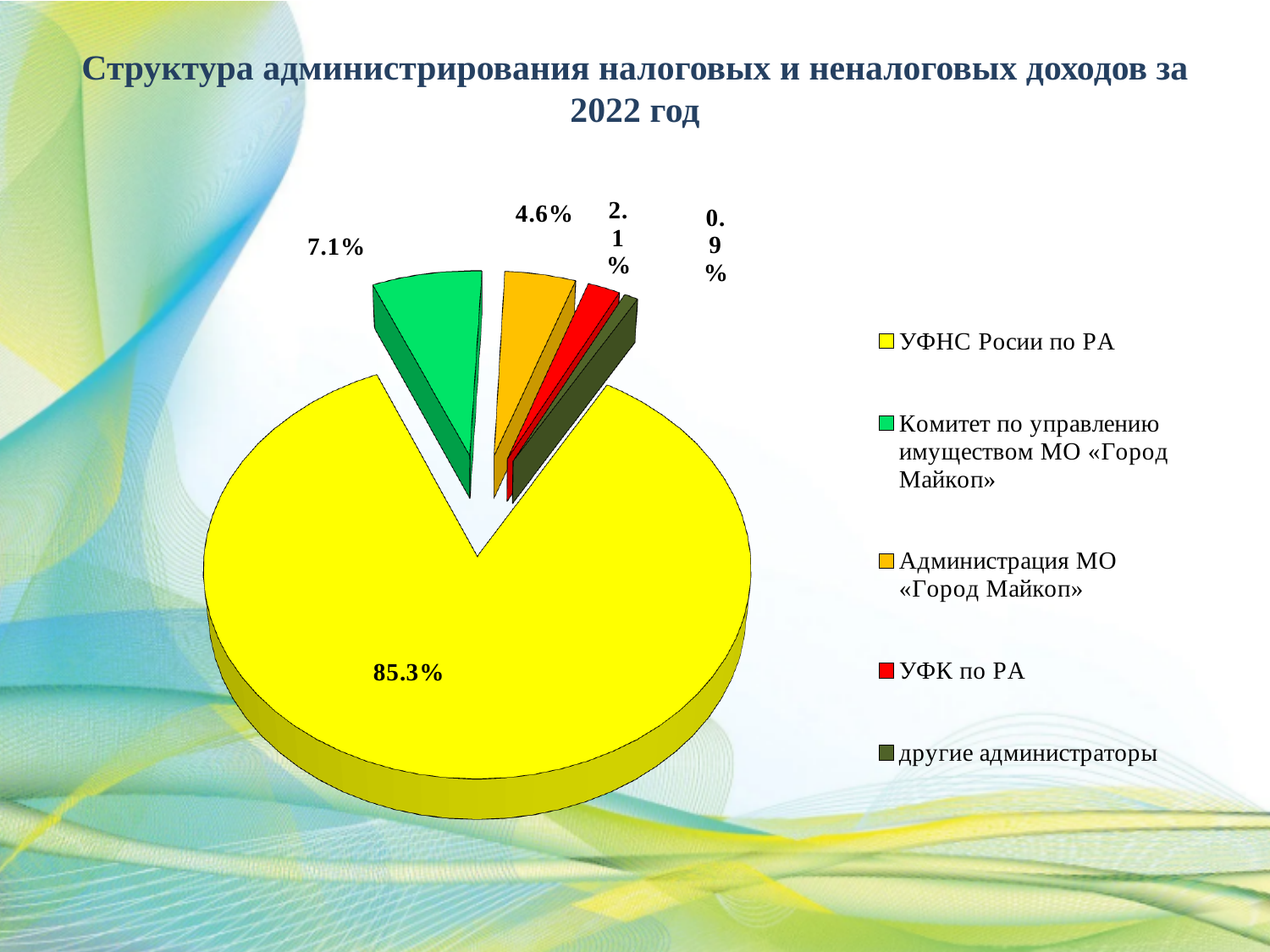
Which is larger, the share of УФК по РА or the share of другие администраторы? УФК по РА Which category has the largest slice of the pie? УФНС Росии по РА What share of the pie does УФНС Росии по РА hold? 85.3% What is the value shown for Комитет по управлению имуществом МО «Город Майкоп»? 7.1% What is the value shown for Администрация МО «Город Майкоп»? 4.6% Which category has the smallest slice of the pie? другие администраторы What is the value shown for УФК по РА? 2.1% What colour is the slice for УФНС Росии по РА? yellow What kind of chart is shown on the slide? pie chart How many slices does the pie chart have? 5 What is the difference between the shares of Комитет по управлению имуществом МО «Город Майкоп» and Администрация МО «Город Майкоп»? 2.5% What is the value shown for другие администраторы? 0.9%